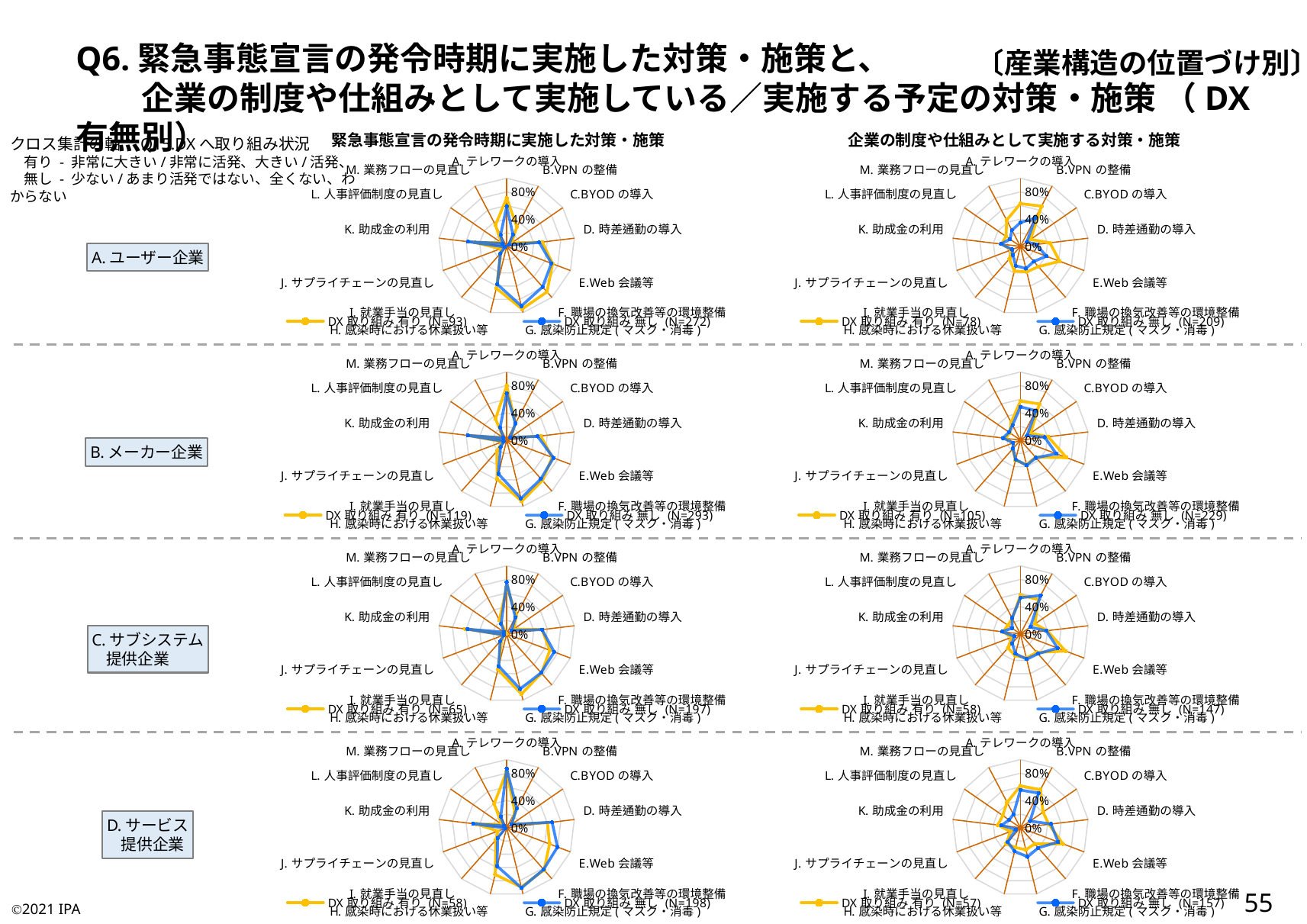
In the chart for D. サービス提供企業 under 緊急事態宣言の発令時期に実施した対策・施策, is the value for A. テレワークの導入 for DX取り組み 無し greater or less than 40%? greater How many series does the legend list in the chart for B. メーカー企業 under 企業の制度や仕組みとして実施する対策・施策? 2 In the chart for B. メーカー企業 under 緊急事態宣言の発令時期に実施した対策・施策, is the value for E.Web会議等 for DX取り組み 無し greater or less than 40%? greater In the chart for C. サブシステム提供企業 under 企業の制度や仕組みとして実施する対策・施策, is the value for A. テレワークの導入 for DX取り組み 無し greater or less than 40%? greater What kind of chart is used for A. ユーザー企業 under 緊急事態宣言の発令時期に実施した対策・施策? radar chart How many radar charts are shown on the slide in total? 8 What are the two legend entries in the chart for D. サービス提供企業 under 緊急事態宣言の発令時期に実施した対策・施策? DX取り組み 有り (N=58), DX取り組み 無し (N=198) How many categories (axes) are plotted in the chart for C. サブシステム提供企業 under 緊急事態宣言の発令時期に実施した対策・施策? 13